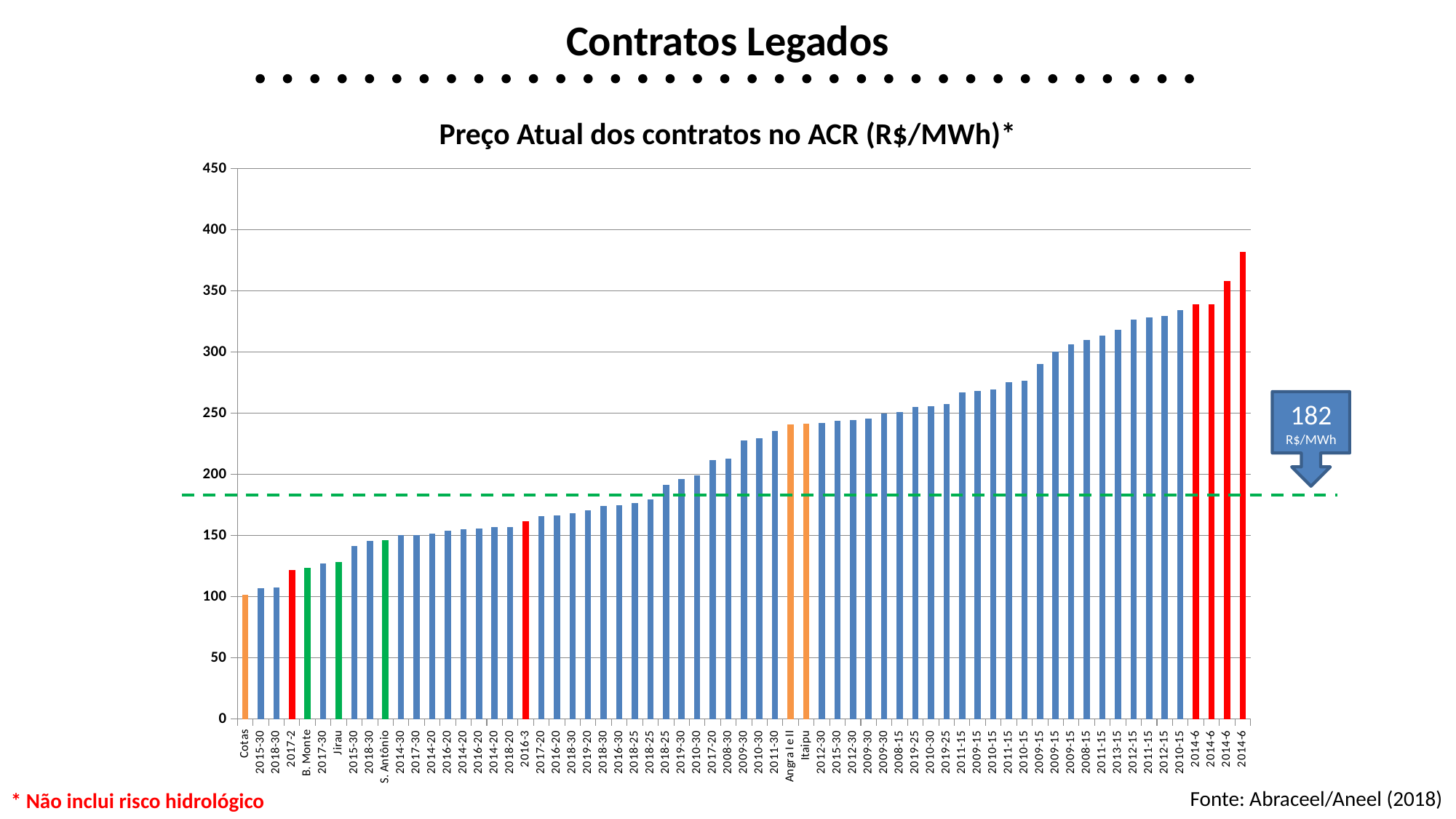
Is the value for 2017-2 greater or less than 150? less What is the title of the chart? Preço Atual dos contratos no ACR (R$/MWh)* Which category has the lowest value in the chart? Cotas Do the bar values generally rise or fall from left to right along the x axis? rise What value does the dashed green horizontal line mark, according to the callout? 182 R$/MWh Is the value for Angra I e II greater or less than 200? greater Is the value for Cotas greater or less than 150? less What kind of chart is shown on the slide? bar chart Which is larger, the value for Itaipu or the value for Jirau? Itaipu